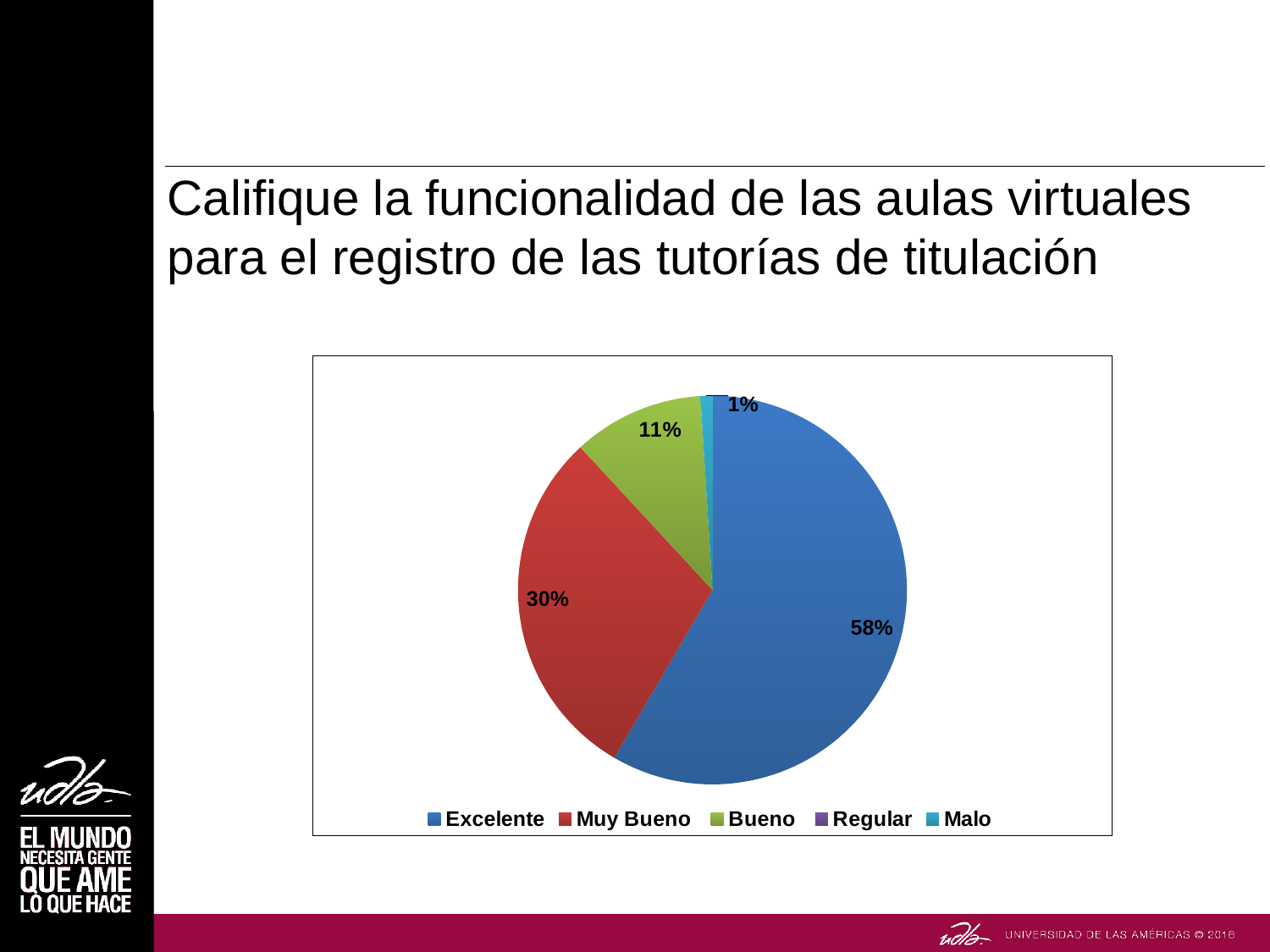
What colour represents the Excelente category in the pie chart? blue What percentage is shown for the Malo category? 1% Which category with a printed label has the smallest share of the pie? Malo What percentage is shown for the Bueno category? 11% Which is larger, the share for Muy Bueno or the share for Bueno? Muy Bueno How many categories does the legend list? 5 What is the difference in percentage points between Excelente and Muy Bueno? 28 What is the title of the slide above the chart? Califique la funcionalidad de las aulas virtuales para el registro de las tutorías de titulación What percentage of respondents rated the virtual classrooms as Excelente? 58% Which category has the largest share of the pie? Excelente What kind of chart is shown on the slide? pie chart What share of the pie corresponds to Muy Bueno? 30%